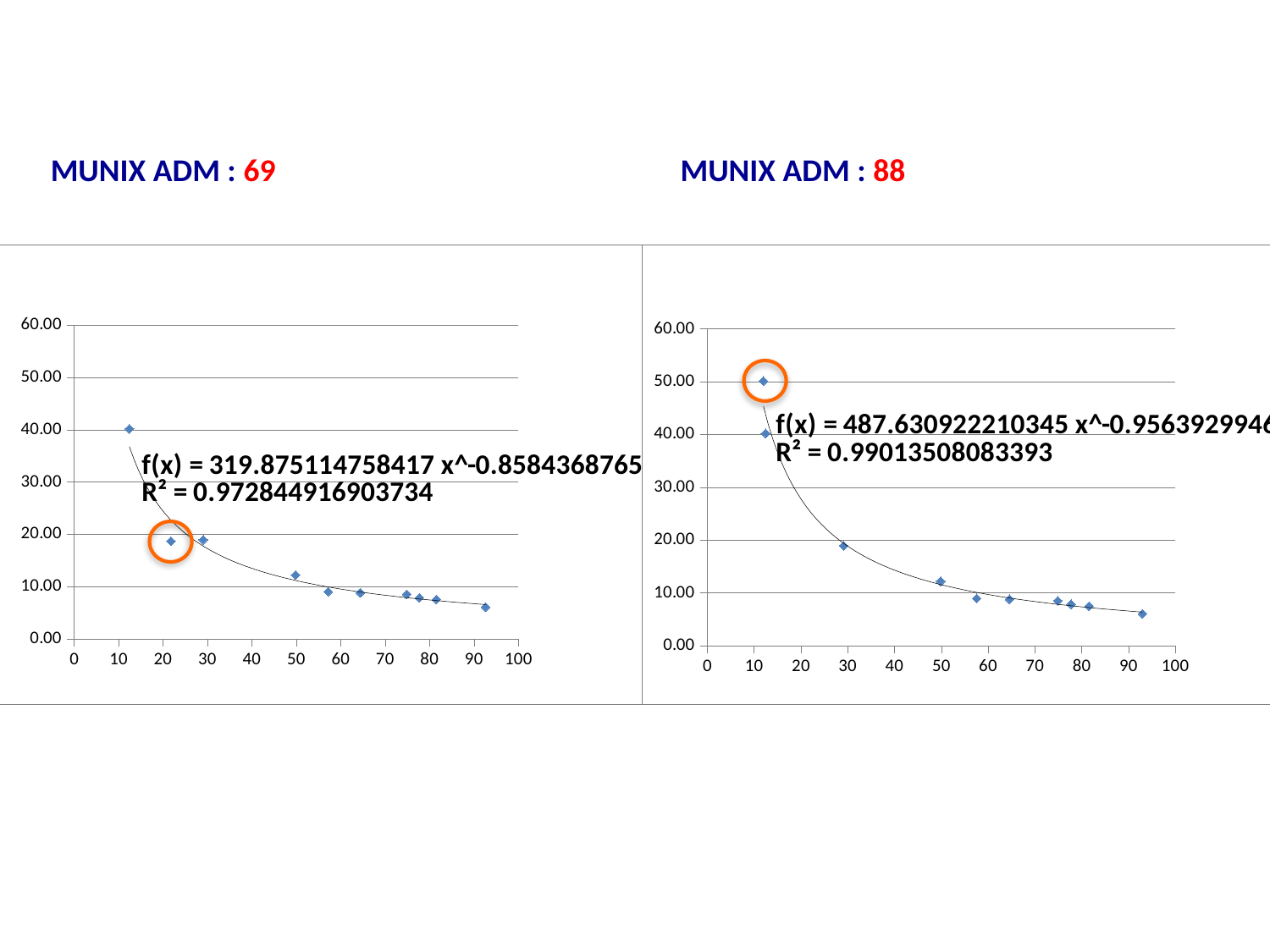
In the right chart (MUNIX ADM : 88), do the plotted values rise or fall as x increases? Fall In the left chart (MUNIX ADM : 69), is the value of the circled point greater or less than 30? less In the right chart (MUNIX ADM : 88), is the value of the circled point greater or less than 40? greater What kind of chart is the left chart (MUNIX ADM : 69)? Scatter chart What R² value is shown on the left chart (MUNIX ADM : 69)? 0.972844916903734 How many data points are plotted in the left chart (MUNIX ADM : 69)? 10 In the left chart (MUNIX ADM : 69), is the value of the leftmost point (near x = 10) greater or less than 30? greater In the left chart (MUNIX ADM : 69), which point has the larger value: the leftmost point (near x = 10) or the rightmost point (near x = 90)? The leftmost point In the left chart (MUNIX ADM : 69), do the plotted values rise or fall as x increases? Fall What R² value is shown on the right chart (MUNIX ADM : 88)? 0.99013508083393 How many data points are plotted in the right chart (MUNIX ADM : 88)? 10